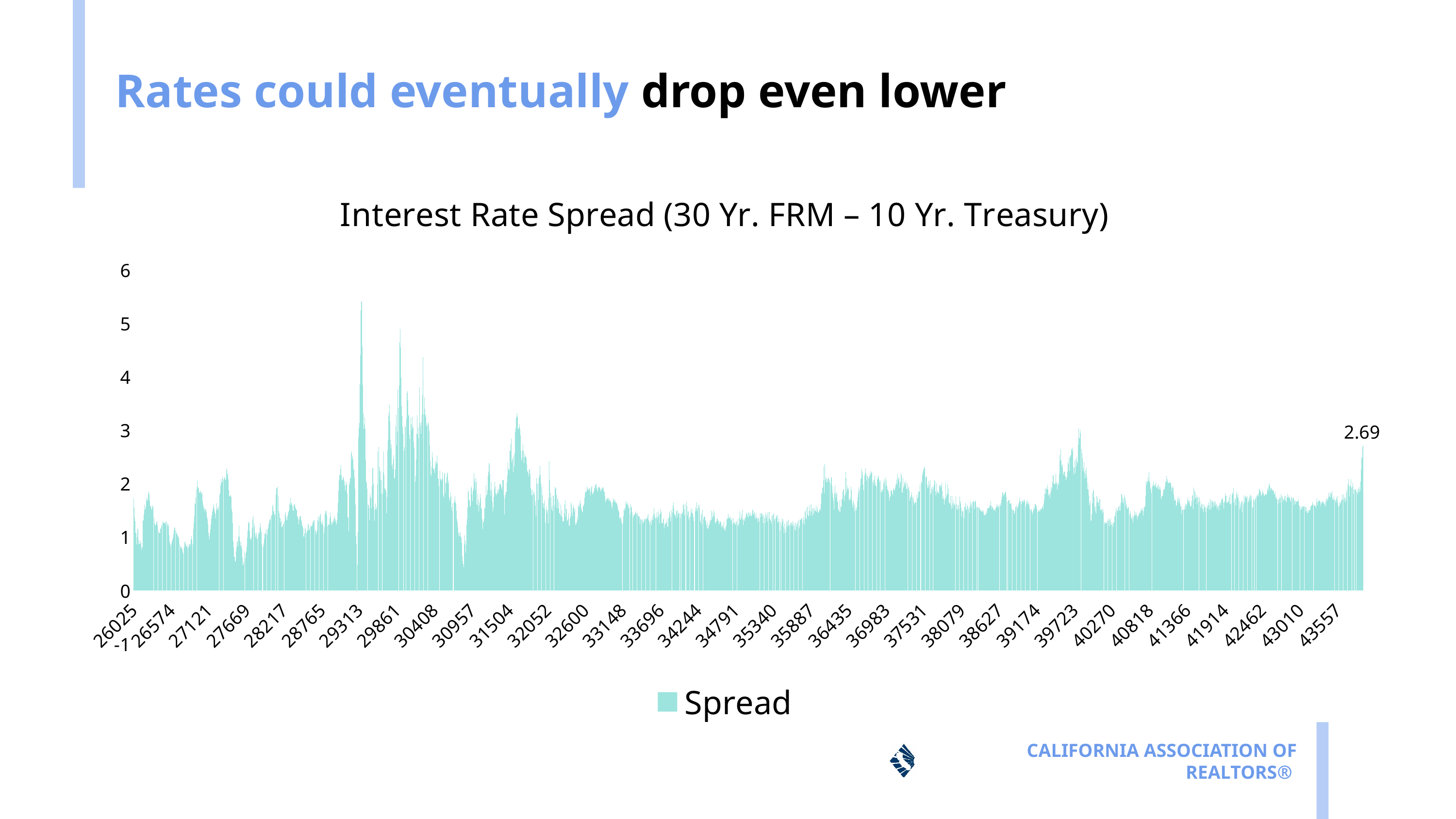
Is the highest bar in the chart greater or less than 5? greater What is the title of the chart? Interest Rate Spread (30 Yr. FRM – 10 Yr. Treasury) Is the value at the x-axis label 35340 greater or less than 2? less What type of chart is shown on the slide? bar chart What is the value of the data label shown at the right end of the chart? 2.69 Is the highest bar in the chart greater or less than 4? greater What is the name of the series shown in the legend? Spread How many series does the chart legend list? 1 Is the highest bar in the chart located in the left half or the right half of the chart? left half